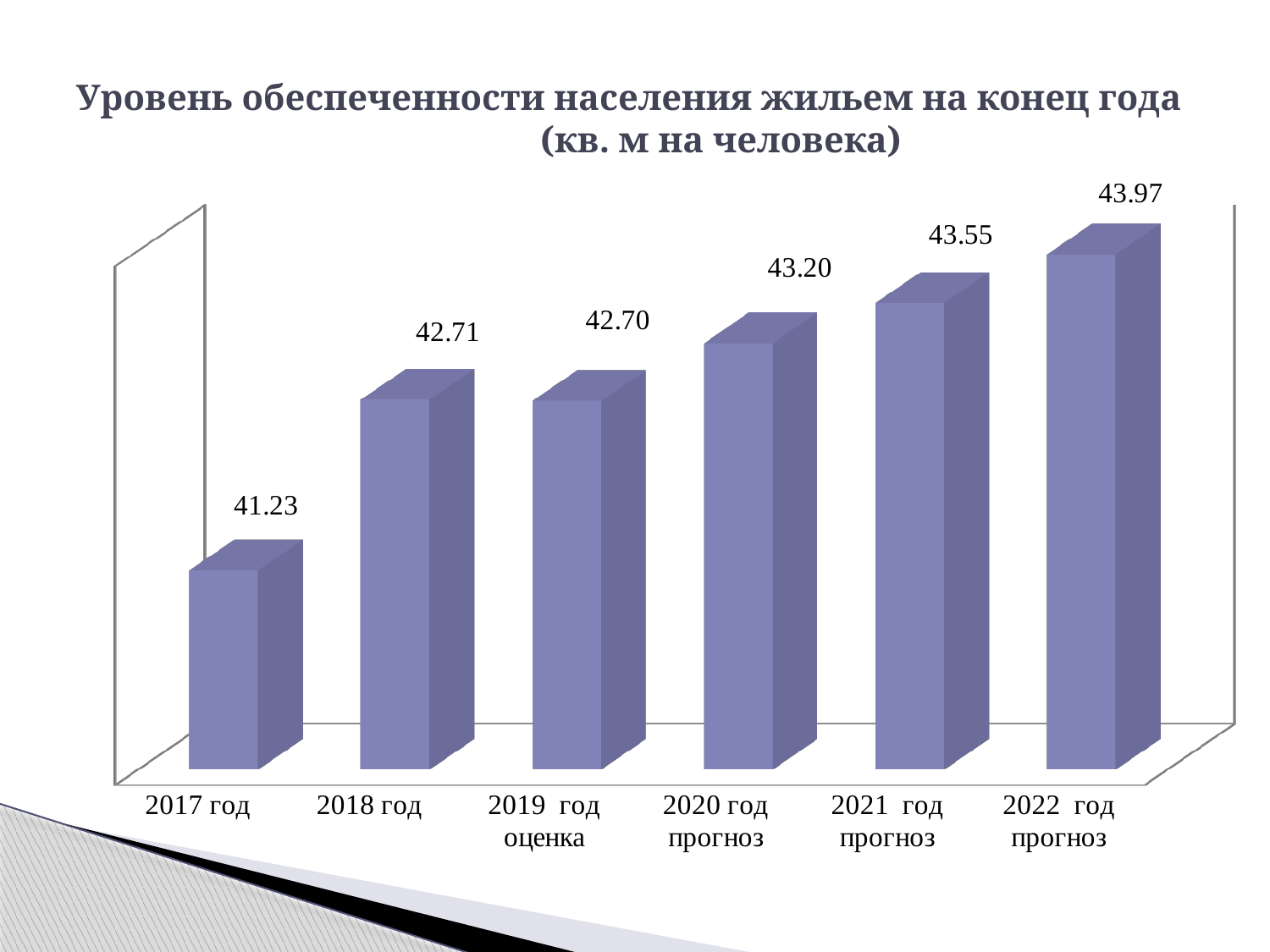
How many categories are shown on the chart? 6 What kind of chart is shown on the slide? Bar chart What is the value for 2022 год прогноз? 43.97 Do the values generally rise or fall from 2017 год to 2022 год прогноз? Rise What is the title of the chart? Уровень обеспеченности населения жильем на конец года (кв. м на человека) Which category has the highest value? 2022 год прогноз Which is larger, the value for 2018 год or the value for 2021 год прогноз? 2021 год прогноз What is the value for 2017 год? 41.23 What is the difference between the values for 2021 год прогноз and 2020 год прогноз? 0.35 What is the difference between the values for 2022 год прогноз and 2017 год? 2.74 Which category has the lowest value? 2017 год What is the value for 2020 год прогноз? 43.20